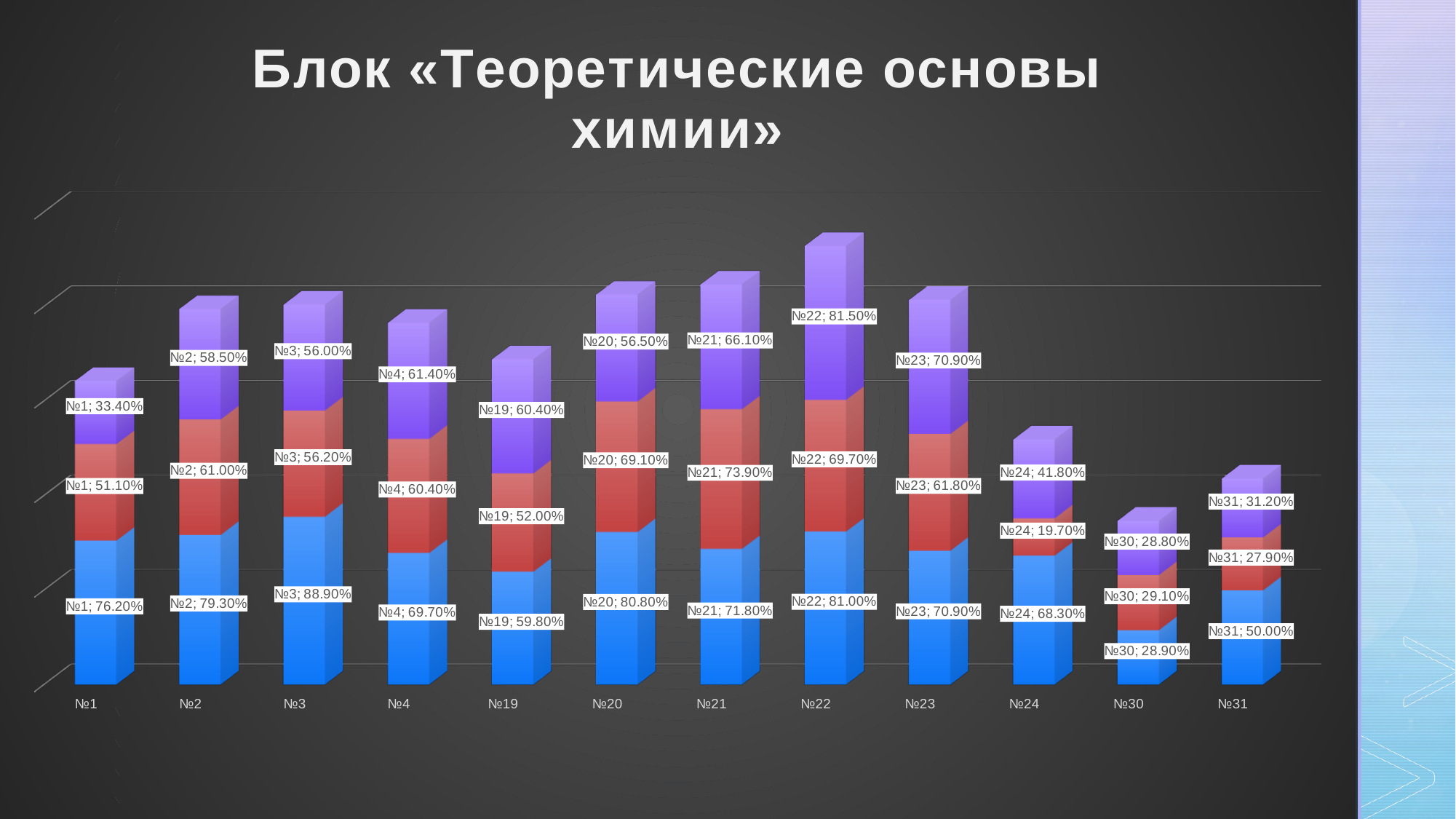
Which category has the lowest value in the middle (red) segment? №24 How many categories (bars) are shown along the x axis? 12 Which category has the highest value in the bottom (blue) segment? №3 What is the title of the slide containing the chart? Блок «Теоретические основы химии» What is the value of the bottom (blue) segment for category №3? 88.90% Which category has the lowest value in the bottom (blue) segment? №30 Which is larger: the top (purple) segment of №21 or the top (purple) segment of №20? №21 What is the value of the middle (red) segment for category №24? 19.70% What is the total of the three stacked segments for category №30? 86.80% What is the value of the top (purple) segment for category №22? 81.50% What kind of chart is shown on the slide? Stacked bar chart What is the difference between the bottom (blue) segment values of №3 and №1? 12.70 percentage points